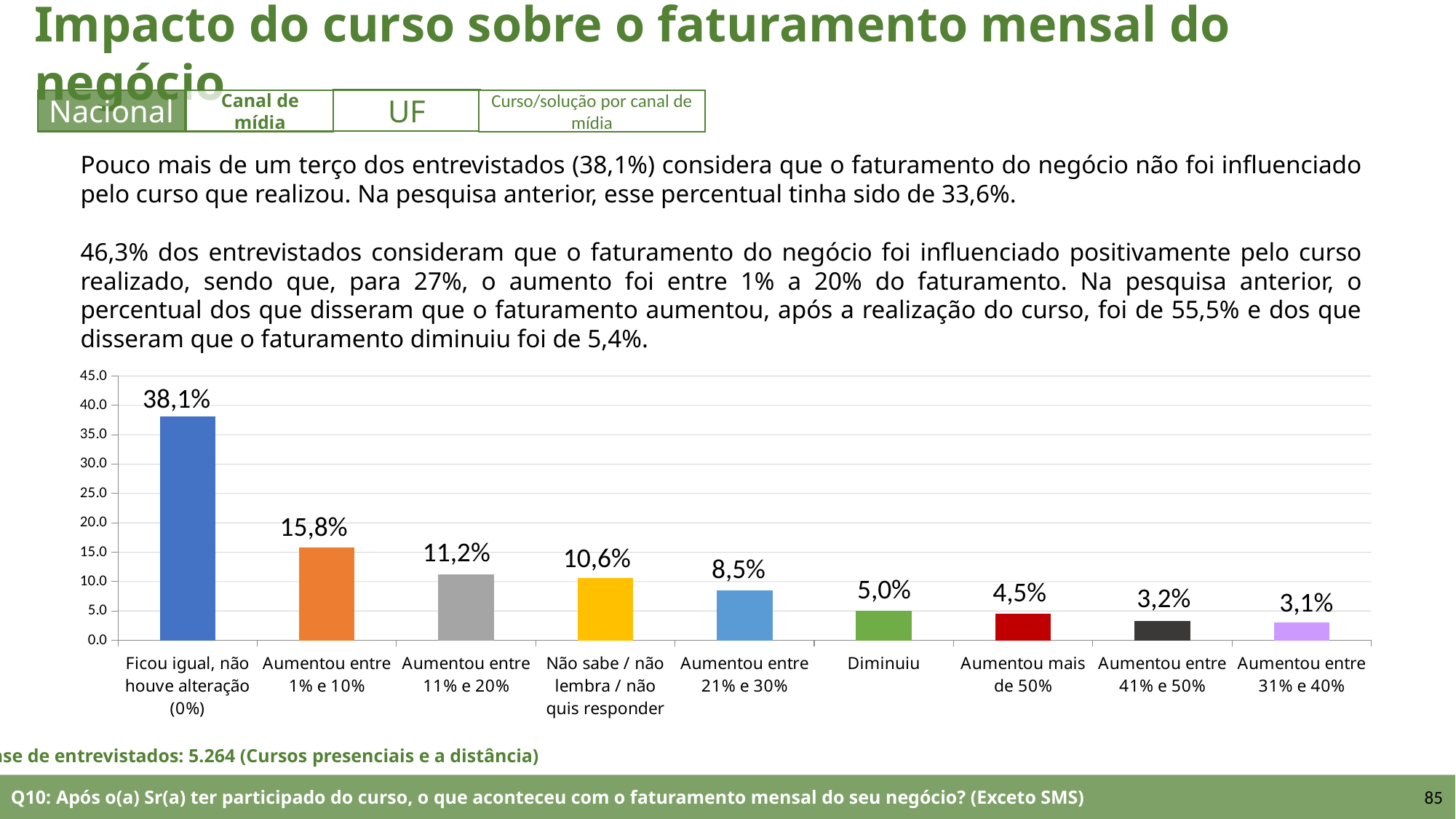
How many categories are shown in the chart? 9 What is the difference between 'Aumentou entre 1% e 10%' and 'Aumentou entre 11% e 20%'? 4,6% What is the value for 'Ficou igual, não houve alteração (0%)'? 38,1% What is the value for 'Não sabe / não lembra / não quis responder'? 10,6% What is the value for 'Aumentou entre 1% e 10%'? 15,8% Which category has the highest value? Ficou igual, não houve alteração (0%) What colour is the bar for 'Aumentou mais de 50%'? dark red Which category has the lowest value? Aumentou entre 31% e 40% What is the value for 'Diminuiu'? 5,0% Which is larger: 'Aumentou entre 21% e 30%' or 'Diminuiu'? Aumentou entre 21% e 30% Is the value for 'Aumentou mais de 50%' greater or less than 5.0? less What kind of chart is shown on the slide? bar chart